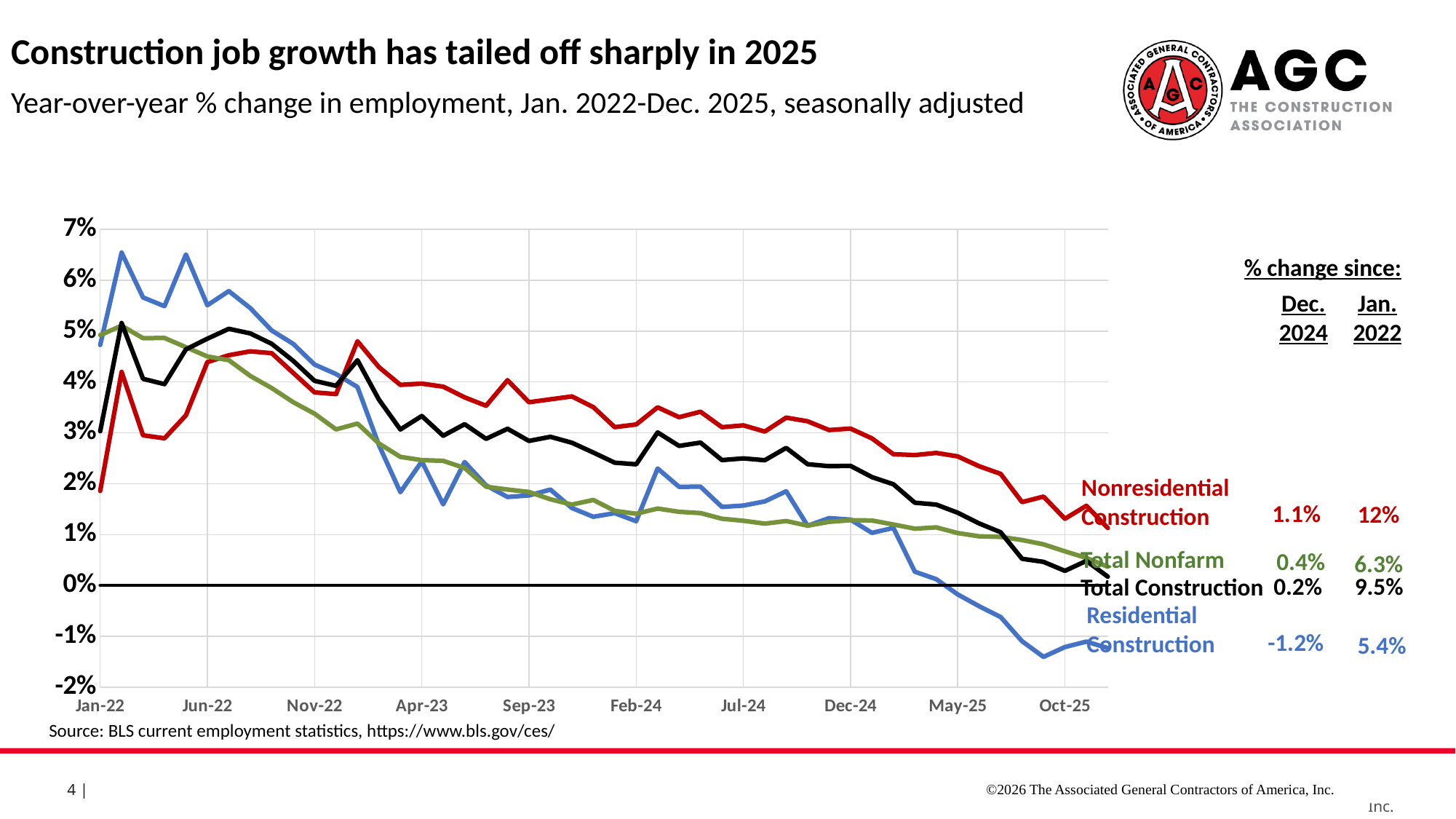
Which has the larger % change since Jan. 2022, Total Nonfarm or Total Construction? Total Construction Is the value for Residential Construction at Oct-25 greater or less than -1%? less What is the % change since Jan. 2022 for Total Construction? 9.5% What is the % change since Jan. 2022 for Total Nonfarm? 6.3% What is the % change since Dec. 2024 for Residential Construction? -1.2% Does the Total Construction line generally rise or fall from Jan-22 to the end of the chart? fall How many data series are plotted on the chart? 4 What is the % change since Dec. 2024 for Nonresidential Construction? 1.1% What kind of chart is shown on the slide? line chart Which series has the lowest % change since Dec. 2024? Residential Construction What is the difference between the % change since Jan. 2022 for Nonresidential Construction and for Total Construction? 2.5 percentage points Which series has the highest % change since Jan. 2022? Nonresidential Construction